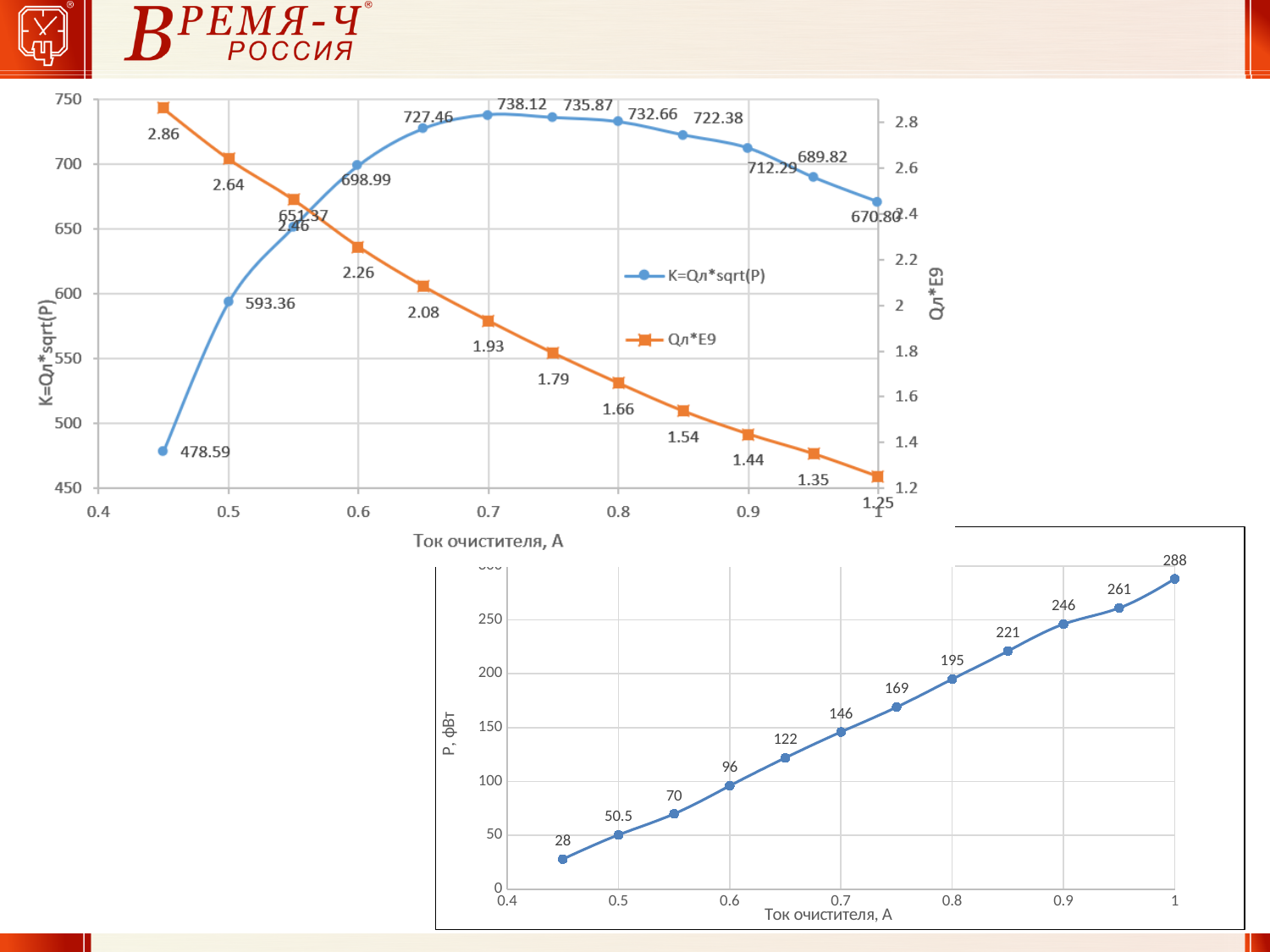
In the top-left chart, does the Qл*E9 series rise or fall as the cleaner current increases? fall In the top-left chart, what is the lowest labelled value of the Qл*E9 series? 1.25 In the top-left chart, how many series does the legend list? 2 In the bottom-right chart, how many data points are plotted? 12 In the top-left chart, what is the value of Qл*E9 at a cleaner current of 0.6 A? 2.26 In the top-left chart, what is the value of K=Qл*sqrt(P) at a cleaner current of 0.7 A? 738.12 In the top-left chart, at which cleaner current does K=Qл*sqrt(P) reach its highest value? 0.7 In the bottom-right chart, what is the value of P at a cleaner current of 0.8 A? 195 What kind of chart is the bottom-right chart? line chart In the top-left chart, what is the difference between the K=Qл*sqrt(P) values at 0.5 A and 0.45 A? 114.77 In the bottom-right chart, what is the highest labelled value of P? 288 In the bottom-right chart, what is the difference between P at 0.5 A and P at 0.45 A? 22.5